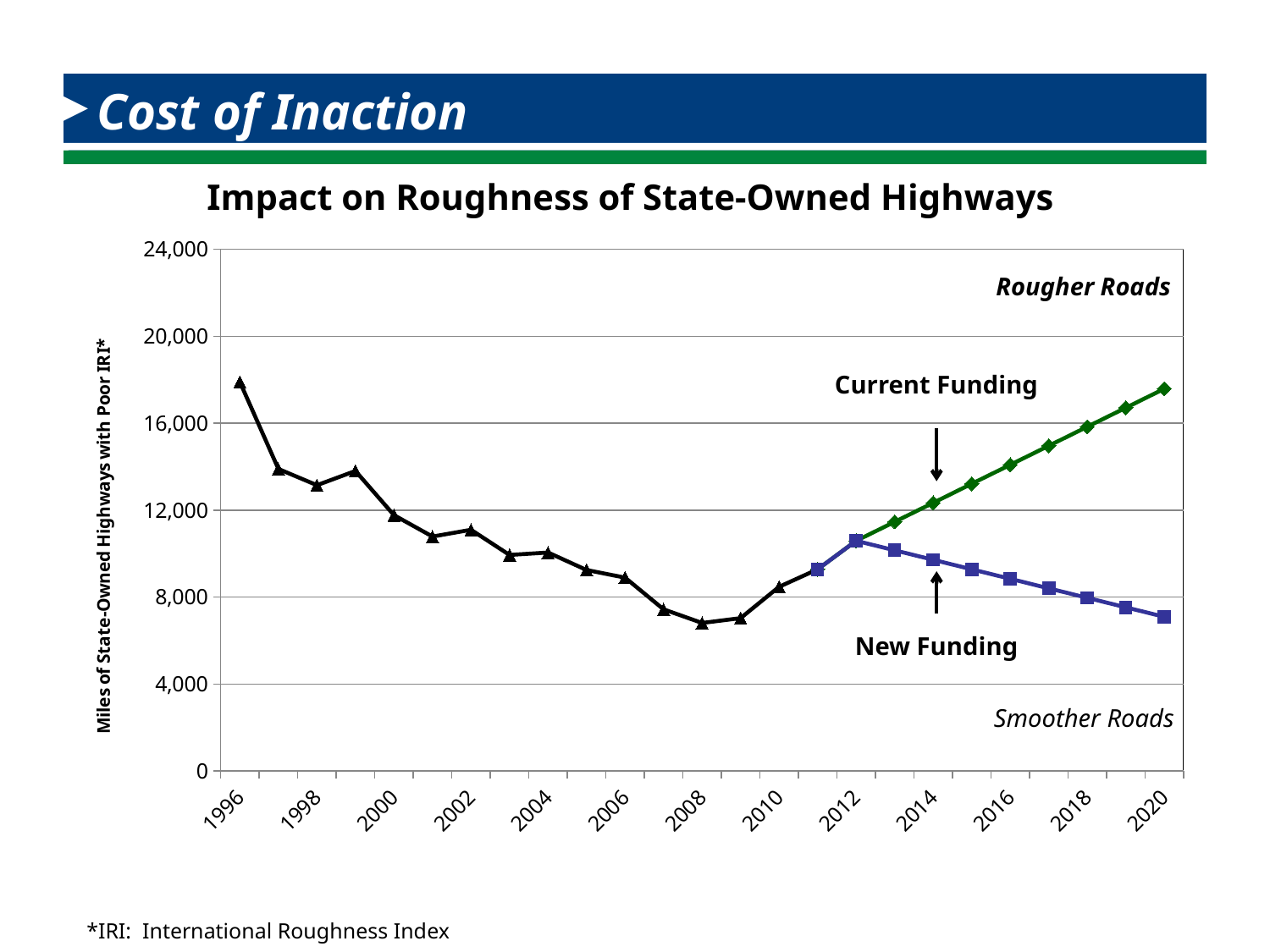
Is the Current Funding value for 2020 greater or less than 16,000? greater Does the New Funding line rise or fall from 2012 to 2020? fall Does the Current Funding line rise or fall from 2012 to 2020? rise In 2020, which line is higher, Current Funding or New Funding? Current Funding Is the New Funding value for 2020 greater or less than 8,000? less Is the value for 2012 greater or less than 12,000? less What is the label on the vertical axis of the chart? Miles of State-Owned Highways with Poor IRI* Which year has the highest value on the chart? 1996 What is the title of the chart? Impact on Roughness of State-Owned Highways What kind of chart is shown on the slide? line chart